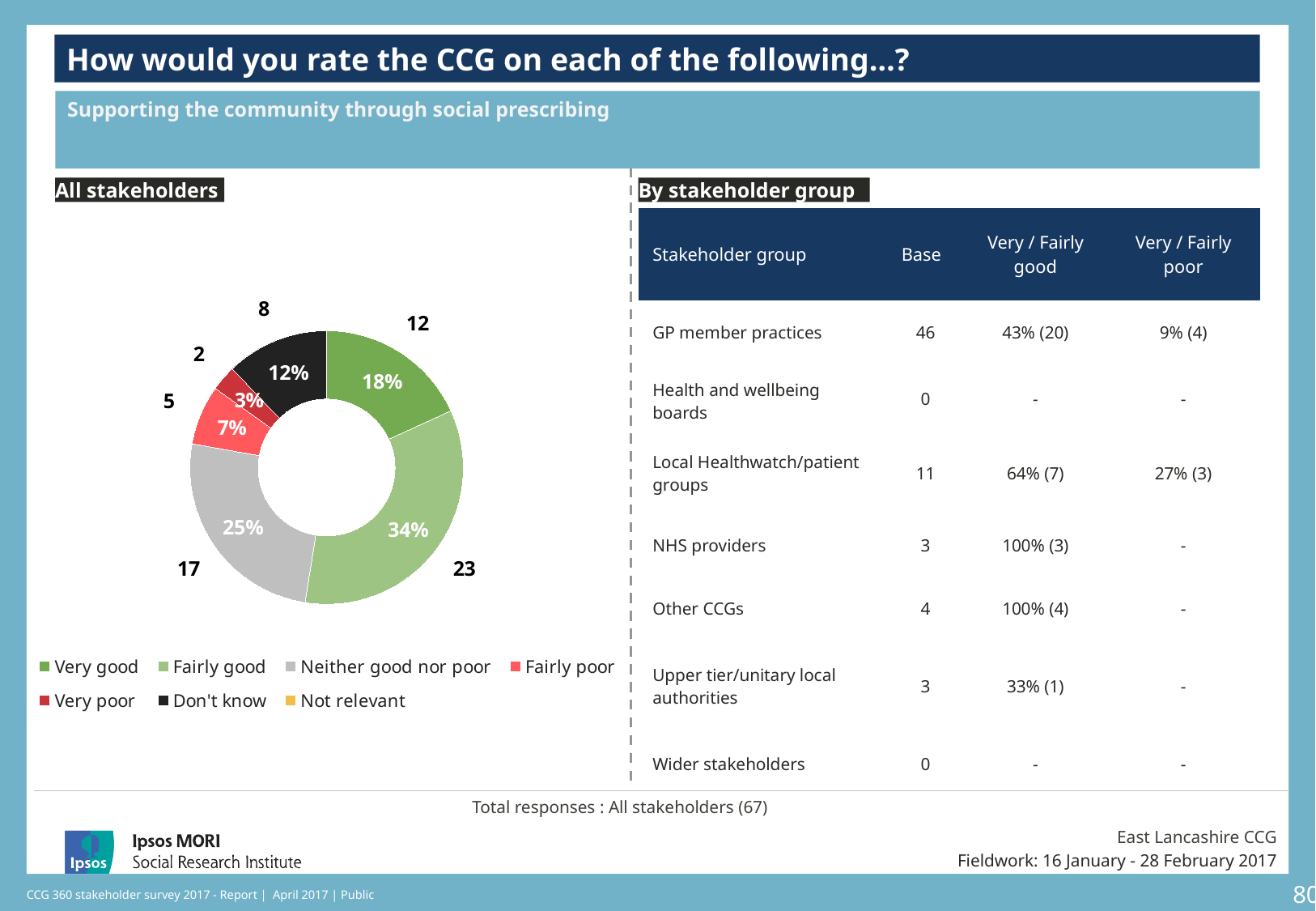
What is the difference in percentage points between 'Fairly good' and 'Very good' in the 'All stakeholders' chart? 16 What is the combined percentage of 'Very good' and 'Fairly good' in the 'All stakeholders' chart? 52% What type of chart is used for 'All stakeholders'? Pie chart (donut) Which rating category has the largest share in the 'All stakeholders' chart? Fairly good How many respondents in the 'All stakeholders' chart answered 'Very good'? 12 What colour represents 'Neither good nor poor' in the 'All stakeholders' chart? Grey How many respondents answered 'Neither good nor poor' in the 'All stakeholders' chart? 17 What percentage of all stakeholders rated the CCG 'Fairly good' on supporting the community through social prescribing? 34% What percentage of all stakeholders answered 'Don't know'? 12% Which rating category shown in the 'All stakeholders' chart has the smallest share? Very poor Which is larger in the 'All stakeholders' chart: 'Fairly poor' or 'Don't know'? Don't know How many entries does the legend of the 'All stakeholders' chart list? 7